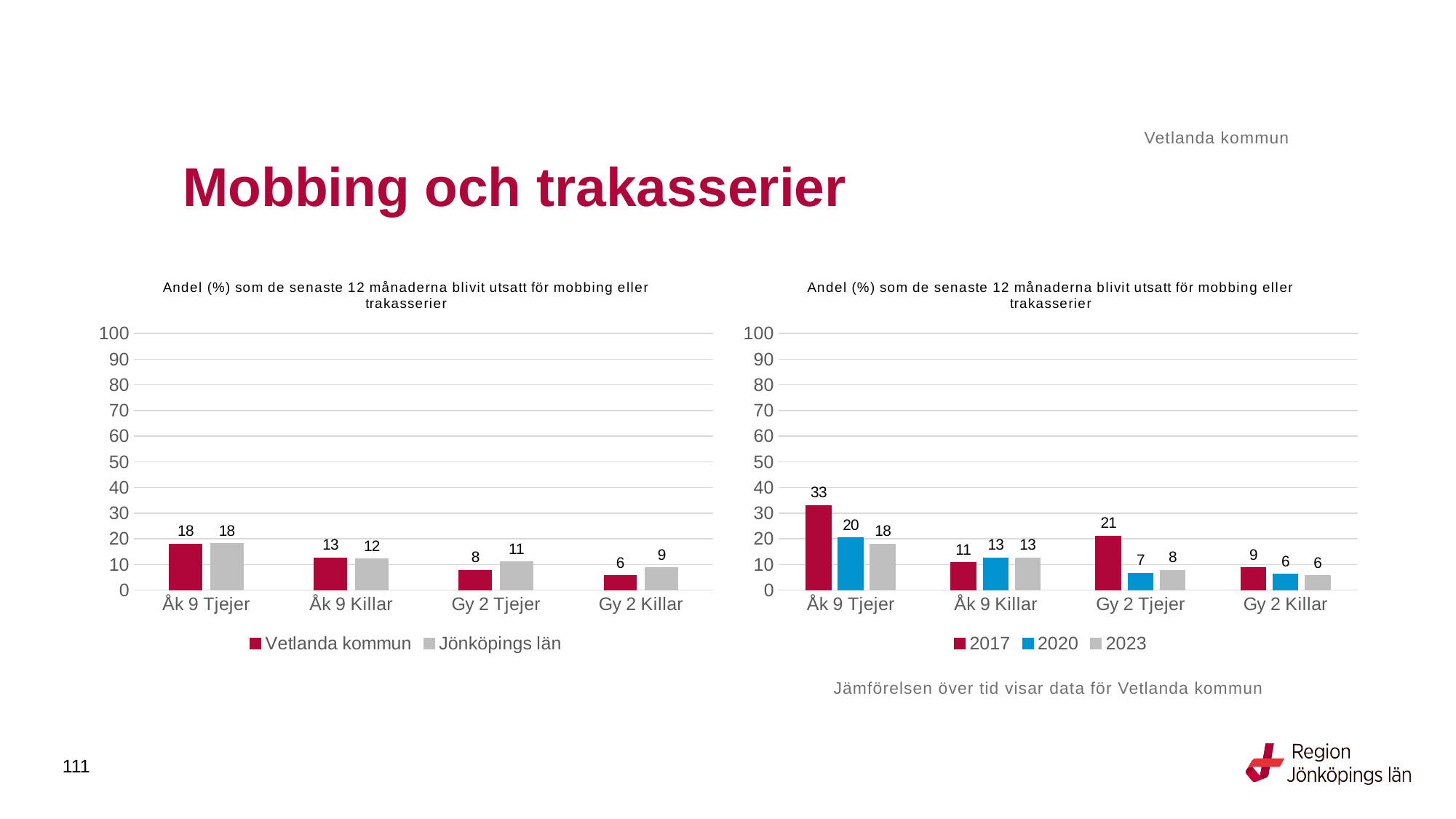
What kind of chart is the right chart? Bar chart In the right chart, which category has the highest value for 2017? Åk 9 Tjejer In the left chart, how many series does the legend list? 2 In the right chart, is the 2017 value for Gy 2 Tjejer larger or the 2023 value for Gy 2 Tjejer? 2017 In the right chart, what is the value for 2020 for Gy 2 Tjejer? 7 In the right chart, what is the value for 2017 for Åk 9 Tjejer? 33 In the left chart, what is the value for Jönköpings län for Gy 2 Tjejer? 11 In the left chart, what is the difference between Jönköpings län and Vetlanda kommun for Gy 2 Killar? 3 In the left chart, which category has the lowest value for Vetlanda kommun? Gy 2 Killar In the right chart, how many categories are shown on the x axis? 4 In the left chart, what is the value for Vetlanda kommun for Åk 9 Tjejer? 18 In the right chart, what is the difference between the 2017 and 2023 values for Åk 9 Tjejer? 15